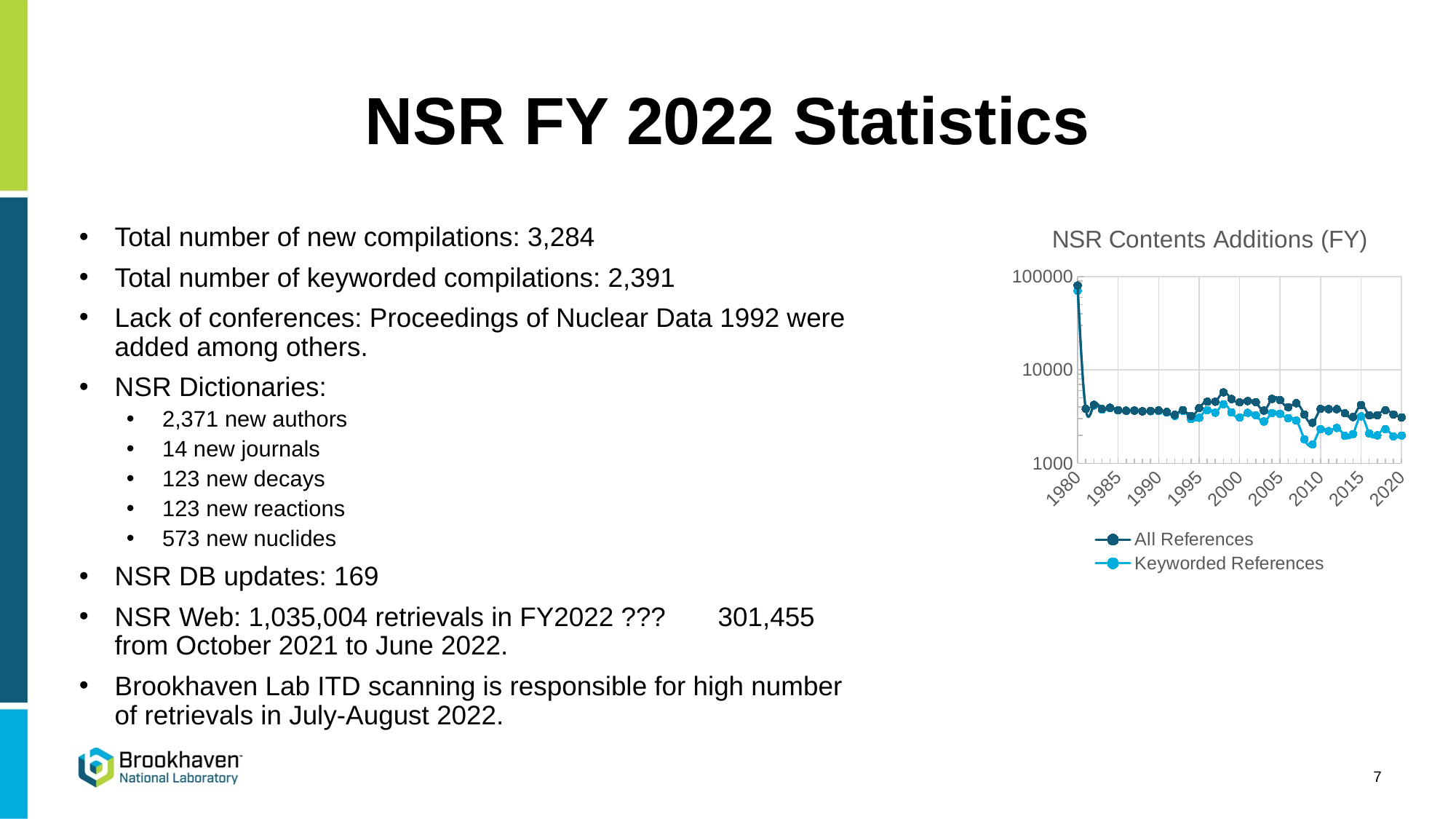
What kind of chart is shown on the slide? line chart Around 2010, which series has the larger value, All References or Keyworded References? All References In which year is the All References value highest? 1980 Is the Keyworded References value for 2010 greater or less than 1000? greater What are the two series named in the chart's legend? All References and Keyworded References How many series does the chart's legend list? 2 Is the All References value for 2020 greater or less than 10000? less Is the All References value for 1980 greater or less than 10000? greater Around 2020, which series has the larger value, All References or Keyworded References? All References What is the title of the chart on the slide? NSR Contents Additions (FY) Do the All References values rise or fall between 1980 and 1985? fall